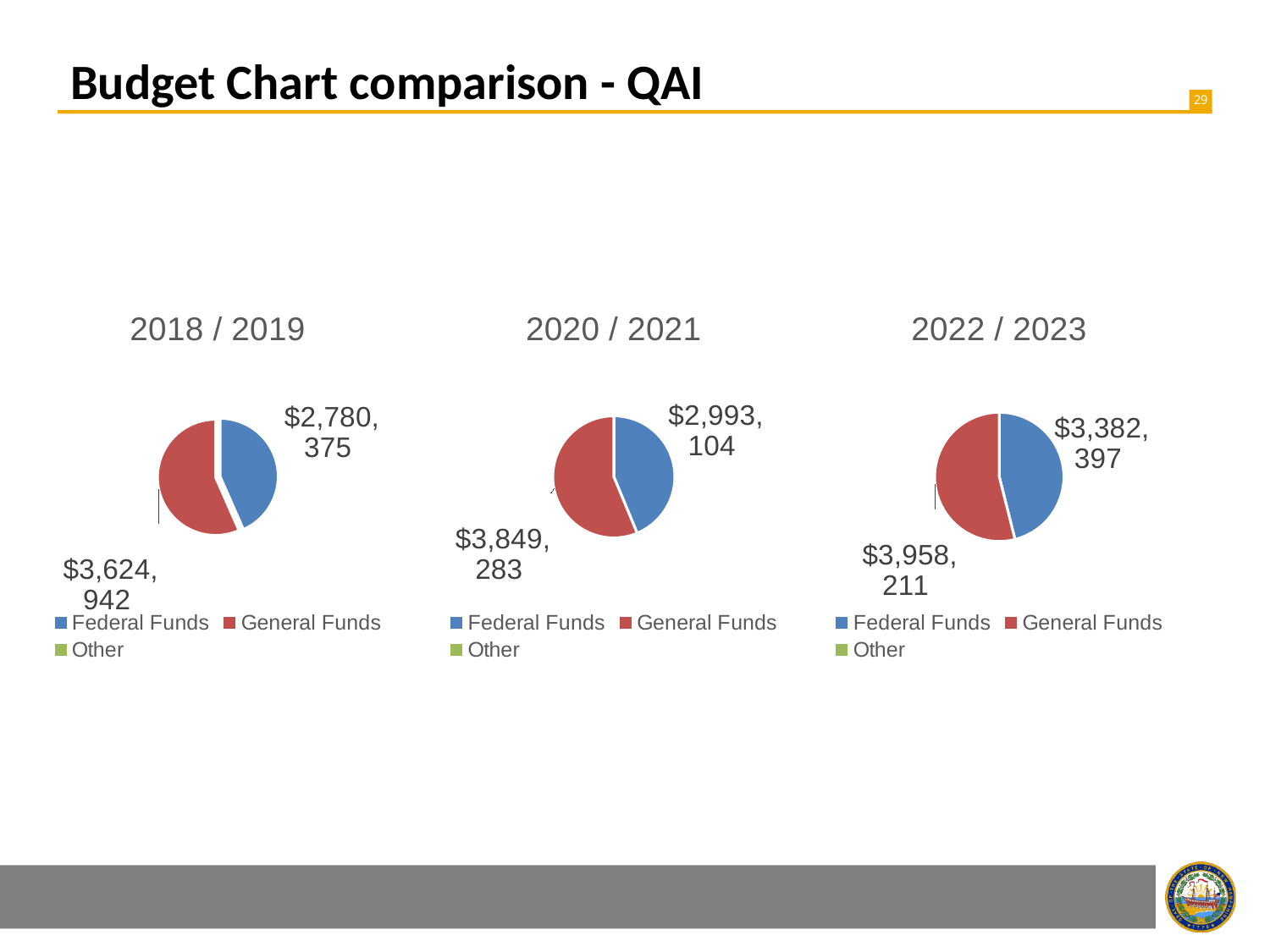
In the 2022 / 2023 chart, what is the difference between General Funds and Federal Funds? $575,814 In the 2022 / 2023 chart, what is the value for Federal Funds? $3,382,397 In the 2018 / 2019 chart, what is the difference between General Funds and Federal Funds? $844,567 In the 2020 / 2021 chart, what is the value for General Funds? $3,849,283 In the 2018 / 2019 chart, what is the value for General Funds? $3,624,942 How many entries does the legend of the 2018 / 2019 chart list? 3 In the 2020 / 2021 chart, what is the value for Federal Funds? $2,993,104 In the 2022 / 2023 chart, what is the value for General Funds? $3,958,211 What kind of chart is the 2020 / 2021 chart? Pie chart In the 2018 / 2019 chart, what is the value for Federal Funds? $2,780,375 In the 2020 / 2021 chart, which category has the largest slice? General Funds In the 2022 / 2023 chart, which is larger, Federal Funds or General Funds? General Funds